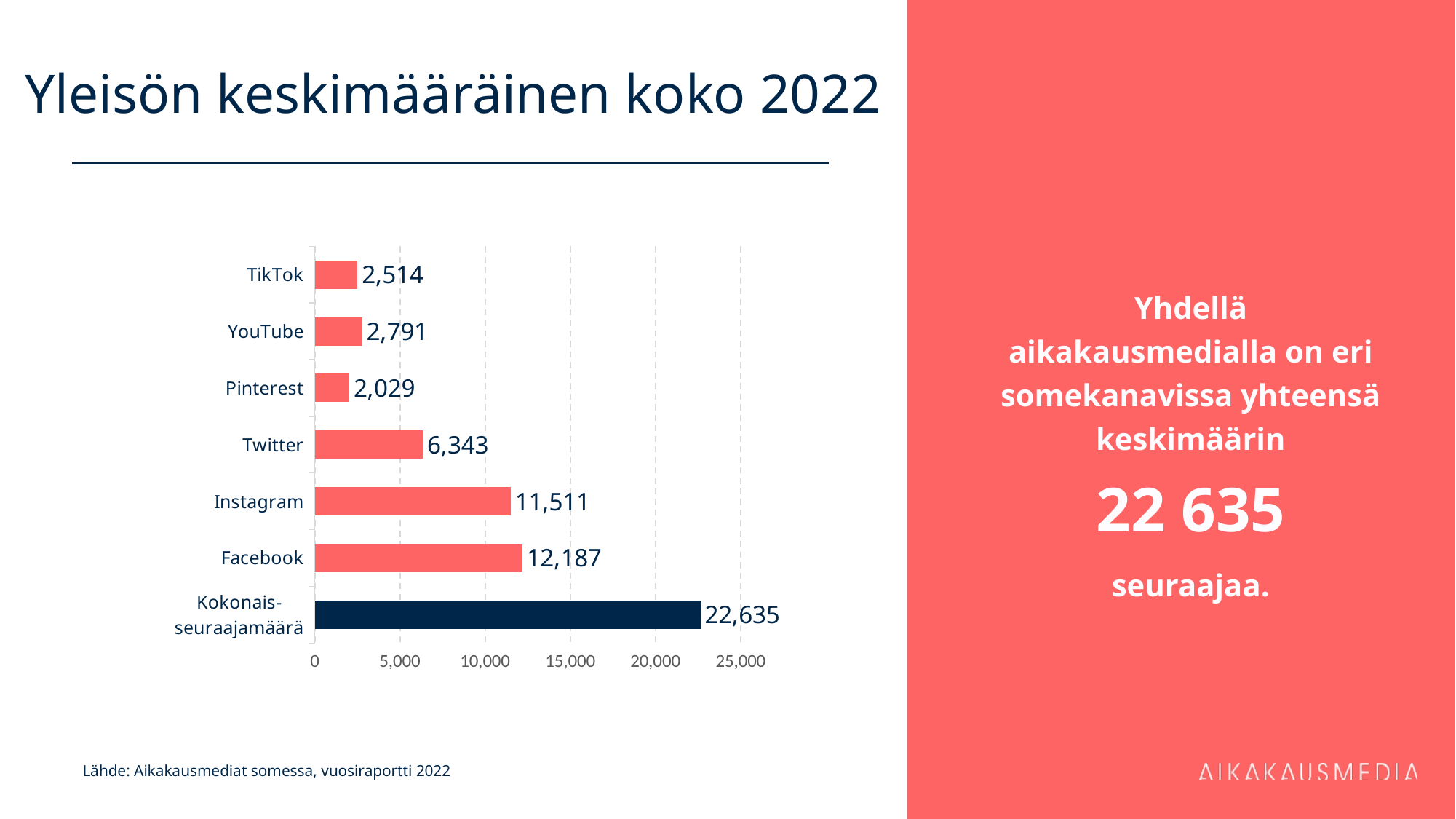
What kind of chart is shown on the slide? bar chart Which bar is coloured dark navy instead of red? Kokonais-seuraajamäärä How many categories are shown in the chart? 7 Which category has the lowest value? Pinterest Which is larger, the value for YouTube or the value for TikTok? YouTube What is the title of the slide? Yleisön keskimääräinen koko 2022 Which individual social media channel has the highest value? Facebook What is the value for Kokonais-seuraajamäärä? 22,635 What is the value for Twitter? 6,343 Is the value for Instagram greater or less than 10,000? greater What is the value for Facebook? 12,187 What is the difference between the values for Facebook and Instagram? 676